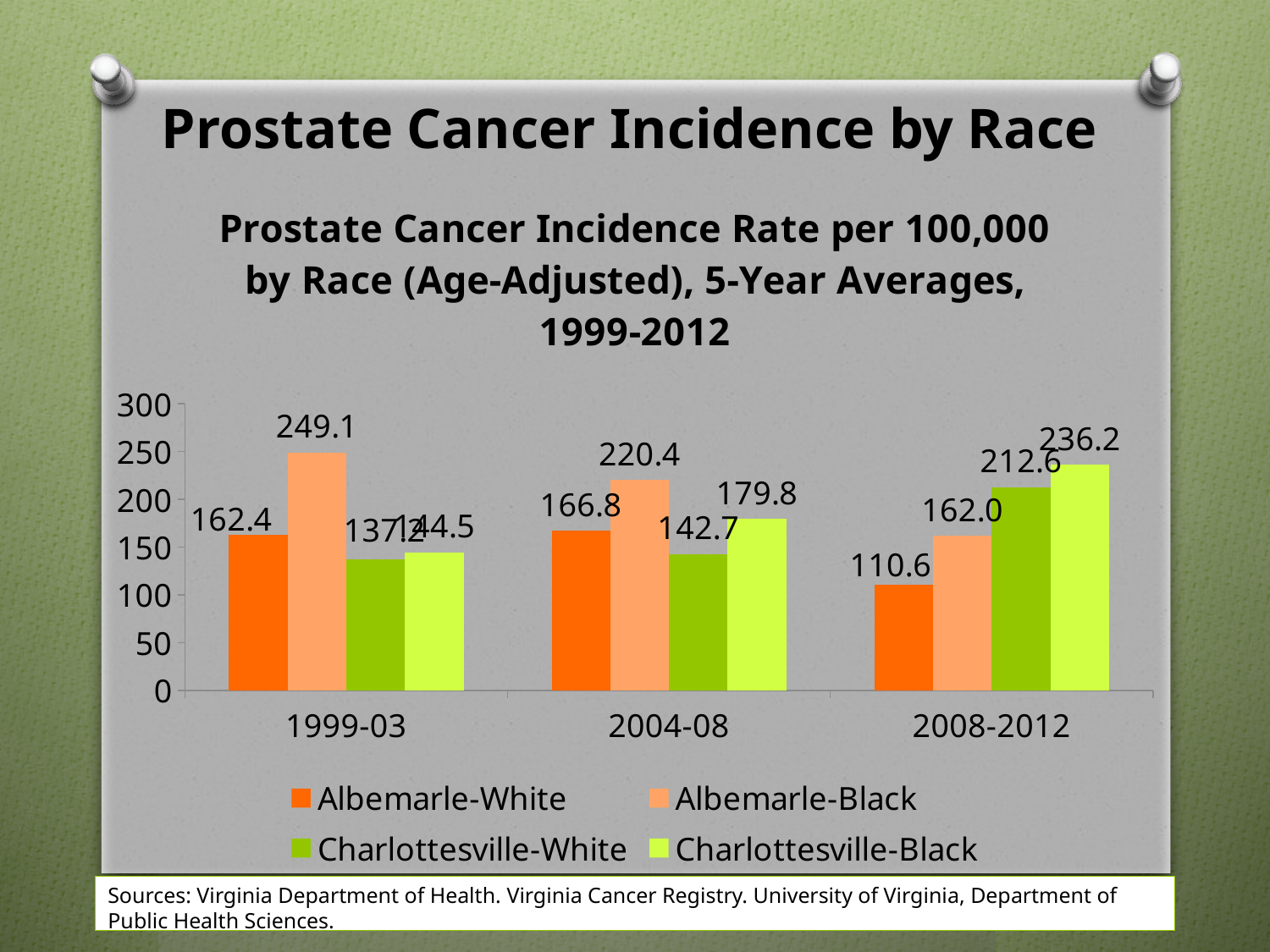
What is the value for Albemarle-White in 2004-08? 166.8 What is the value for Charlottesville-Black in 2008-2012? 236.2 What is the value for Charlottesville-White in 2008-2012? 212.6 Which series has the highest value in the 1999-03 group? Albemarle-Black How many time-period categories are shown on the x axis? 3 What is the difference between Charlottesville-Black and Charlottesville-White in 2004-08? 37.1 Does the value for Albemarle-White rise or fall from 2004-08 to 2008-2012? Fall How many series does the legend list? 4 Which is larger in 2008-2012: Albemarle-Black or Charlottesville-White? Charlottesville-White What is the value for Albemarle-Black in 1999-03? 249.1 What kind of chart is shown on the slide? Bar chart Which series has the lowest value in the 2008-2012 group? Albemarle-White